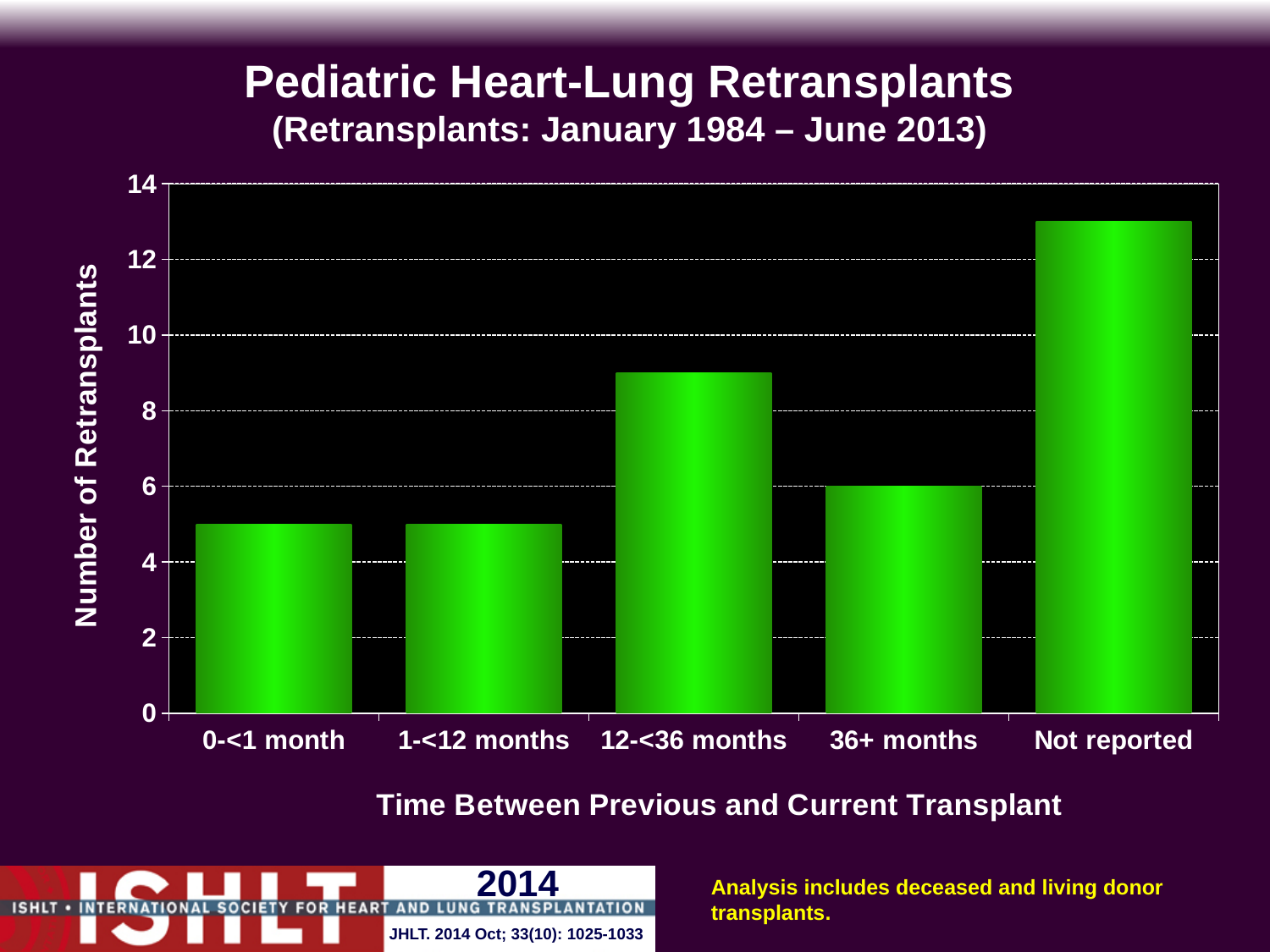
What is the number of retransplants for the 36+ months category? 6 Is the value for 0-<1 month greater or less than 6? less What is the label of the x axis? Time Between Previous and Current Transplant What is the label of the y axis? Number of Retransplants How many categories are shown on the x axis of the chart? 5 Is the value for 12-<36 months greater or less than 8? greater Does the number of retransplants rise or fall from 12-<36 months to 36+ months? fall Which category has the highest number of retransplants? Not reported Is the value for Not reported greater or less than 12? greater What type of chart is shown on the slide? bar chart Which has more retransplants, 12-<36 months or 36+ months? 12-<36 months